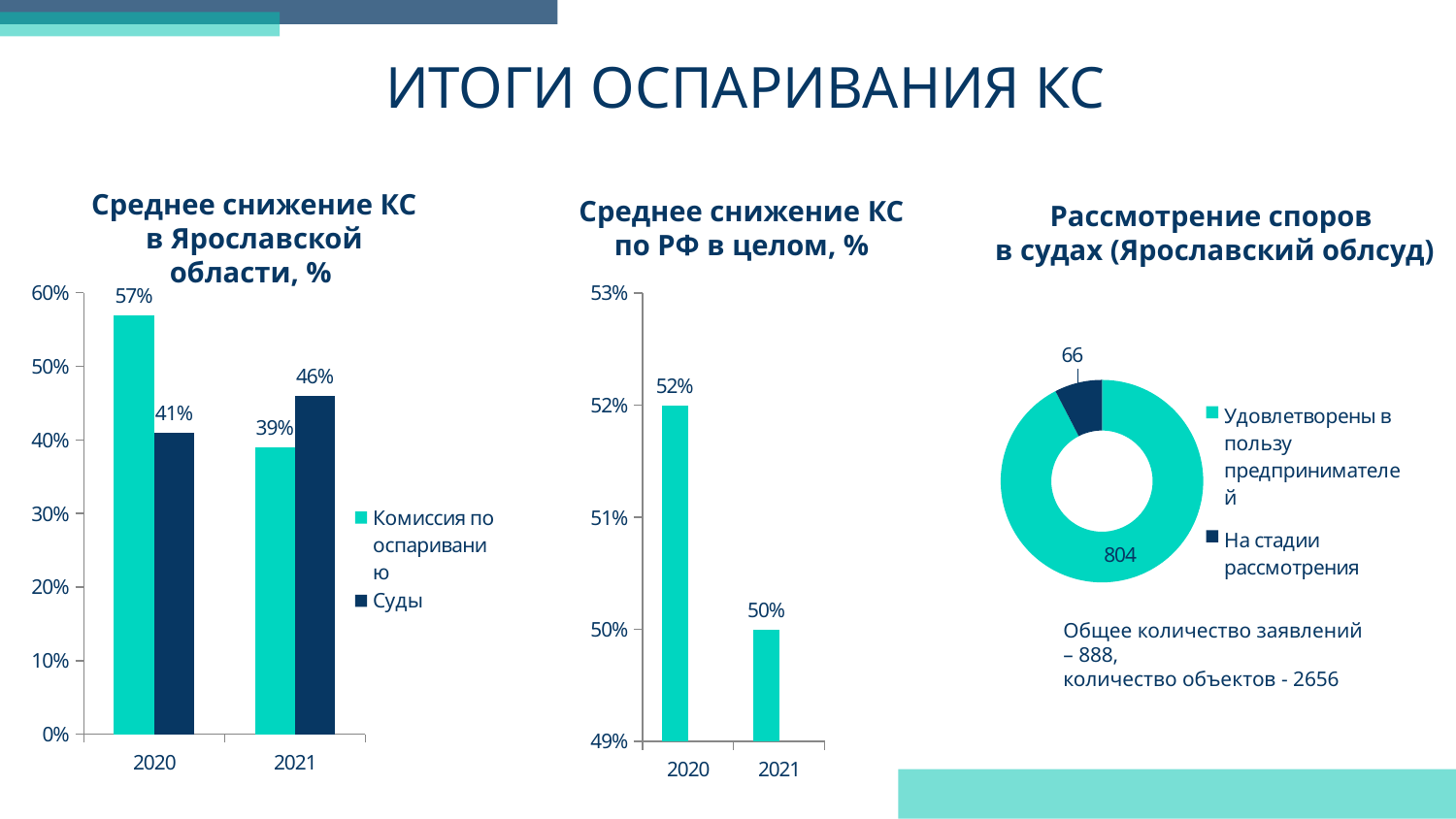
In the chart 'Рассмотрение споров в судах (Ярославский облсуд)', which category has the largest value? Удовлетворены в пользу предпринимателей What kind of chart is 'Рассмотрение споров в судах (Ярославский облсуд)'? Doughnut chart In the chart 'Среднее снижение КС в Ярославской области, %', what is the difference between the 'Комиссия по оспариванию' values for 2020 and 2021? 18% In the chart 'Среднее снижение КС по РФ в целом, %', what is the value for 2021? 50% In the chart 'Среднее снижение КС в Ярославской области, %', what is the value for 'Суды' in 2021? 46% In the chart 'Среднее снижение КС в Ярославской области, %', what is the value for 'Комиссия по оспариванию' in 2020? 57% In the chart 'Среднее снижение КС по РФ в целом, %', do the values rise or fall from 2020 to 2021? Fall What kind of chart is 'Среднее снижение КС по РФ в целом, %'? Bar chart In the chart 'Рассмотрение споров в судах (Ярославский облсуд)', what is the value for 'На стадии рассмотрения'? 66 In the chart 'Среднее снижение КС в Ярославской области, %', which series has the higher value in 2021? Суды In the chart 'Среднее снижение КС по РФ в целом, %', what is the difference between the 2020 and 2021 values? 2% How many series does the legend of the chart 'Среднее снижение КС в Ярославской области, %' list? 2